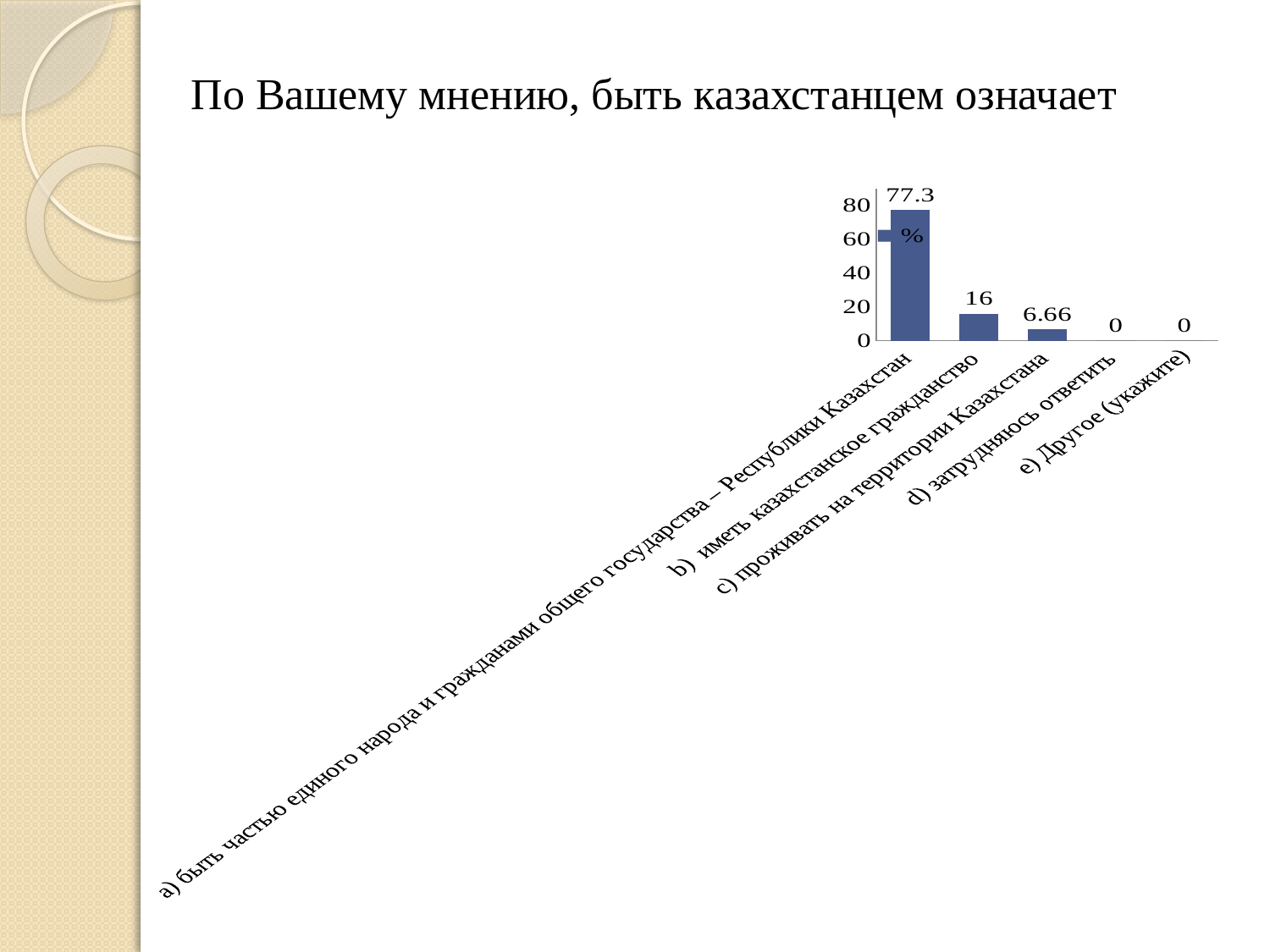
Which category has the highest value? a) быть частью единого народа и гражданами общего государства – Республики Казахстан What is the value for "c) проживать на территории Казахстана"? 6.66 How many categories are shown on the x axis of the chart? 5 How many series does the chart legend list? 1 What is the legend entry of the chart? % What is the difference between the values for "a) быть частью единого народа и гражданами общего государства – Республики Казахстан" and "b) иметь казахстанское гражданство"? 61.3 What is the difference between the values for "b) иметь казахстанское гражданство" and "c) проживать на территории Казахстана"? 9.34 What is the value for "d) затрудняюсь ответить"? 0 What is the value for "a) быть частью единого народа и гражданами общего государства – Республики Казахстан"? 77.3 What is the value for "b) иметь казахстанское гражданство"? 16 What kind of chart is shown on the slide? bar chart Which is larger: the value for "b) иметь казахстанское гражданство" or for "c) проживать на территории Казахстана"? b) иметь казахстанское гражданство